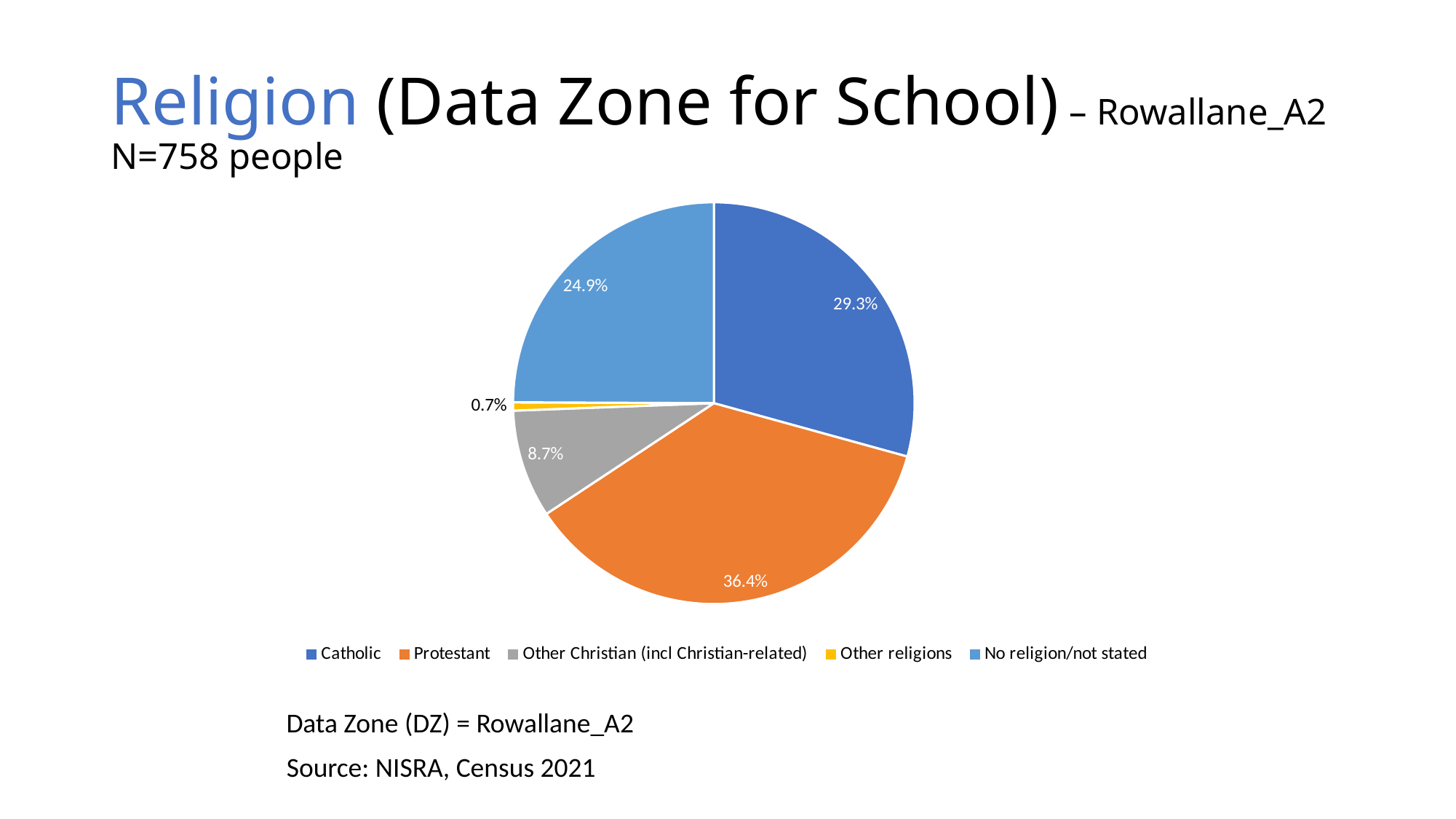
What is the difference in percentage points between Protestant and Catholic? 7.1 What percentage of people are No religion/not stated? 24.9% What percentage of people are Other Christian (incl Christian-related)? 8.7% How many categories does the legend list? 5 Which category has the smallest share of the pie? Other religions What percentage of people are Catholic? 29.3% What kind of chart is shown on the slide? pie chart What percentage of people are Other religions? 0.7% Which is larger, the Catholic share or the No religion/not stated share? Catholic What percentage of people are Protestant? 36.4% What colour represents Protestant in the pie chart? orange Which category has the largest share of the pie? Protestant